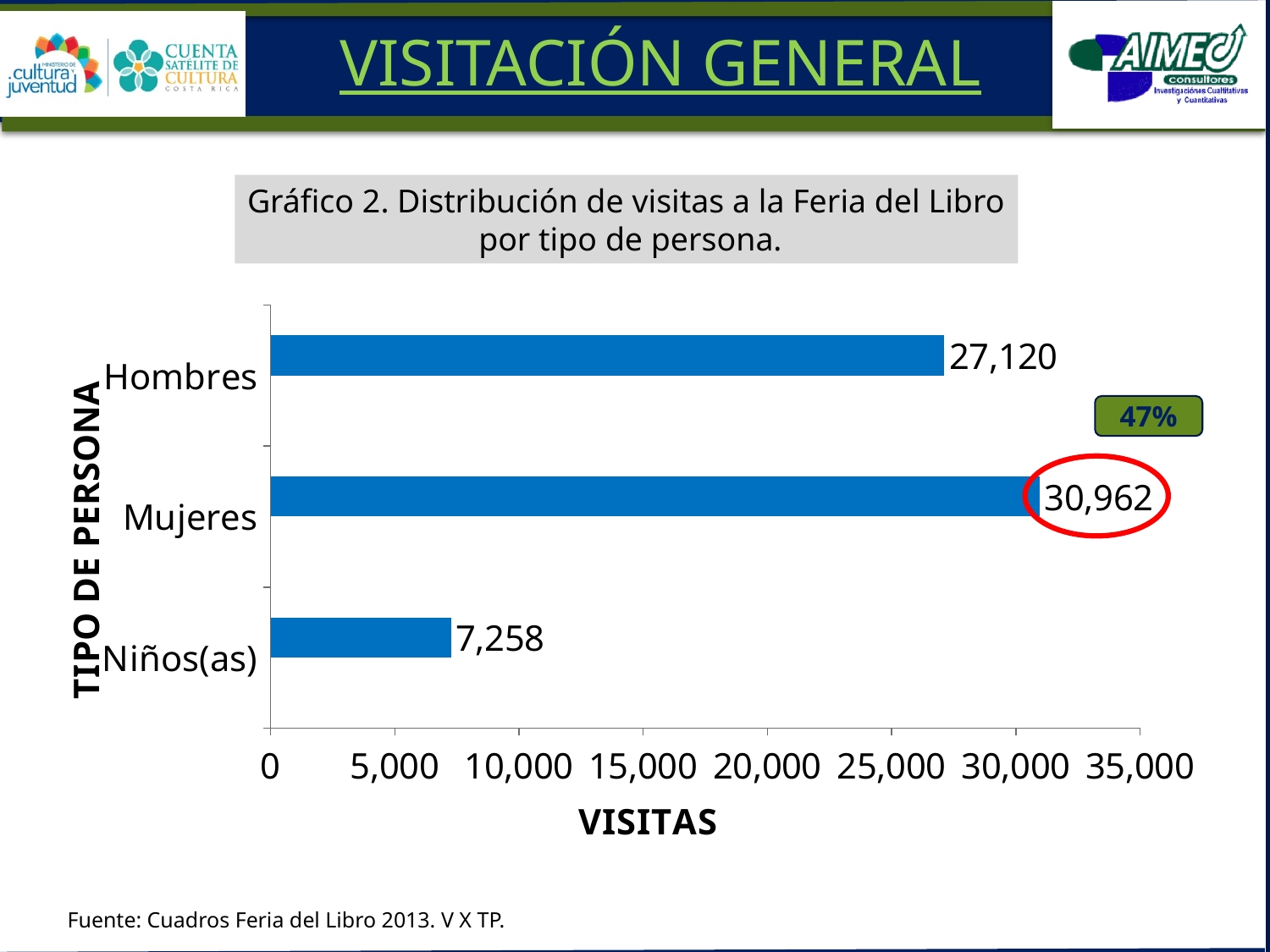
Is the value for Mujeres greater or less than 30,000? greater Which type of person has the highest number of visits? Mujeres Which has more visits, Hombres or Niños(as)? Hombres What is the difference in visits between Hombres and Niños(as)? 19,862 How many types of person are shown in the chart? 3 What is the label of the horizontal axis of the chart? VISITAS Which type of person has the lowest number of visits? Niños(as) What is the number of visits for Niños(as)? 7,258 What kind of chart is shown on the slide? bar chart What is the difference in visits between Mujeres and Hombres? 3,842 What is the number of visits for Mujeres? 30,962 What is the number of visits for Hombres? 27,120